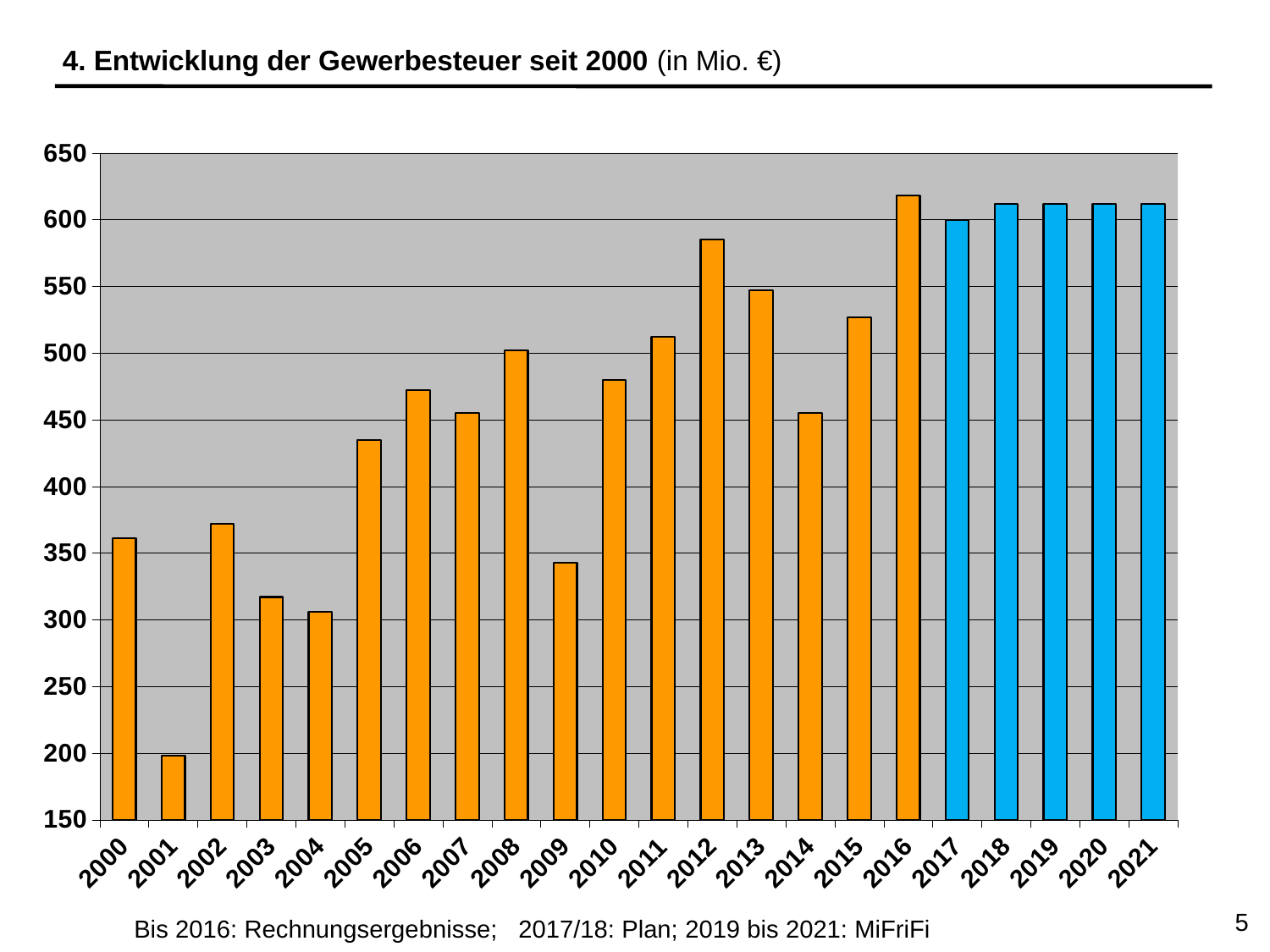
Which year has the lowest Gewerbesteuer value in the chart? 2001 Is the value for 2009 greater or less than 400? less Which year has the larger value, 2002 or 2003? 2002 Is the value for 2016 greater or less than 600? greater Which year has the larger value, 2012 or 2013? 2012 What kind of chart is shown on the slide? bar chart Which year has the highest Gewerbesteuer value in the chart? 2016 Which years are shown with blue bars instead of orange bars? 2017 to 2021 Is the value for 2001 greater or less than 250? less How many years (bars) are shown in the chart? 22